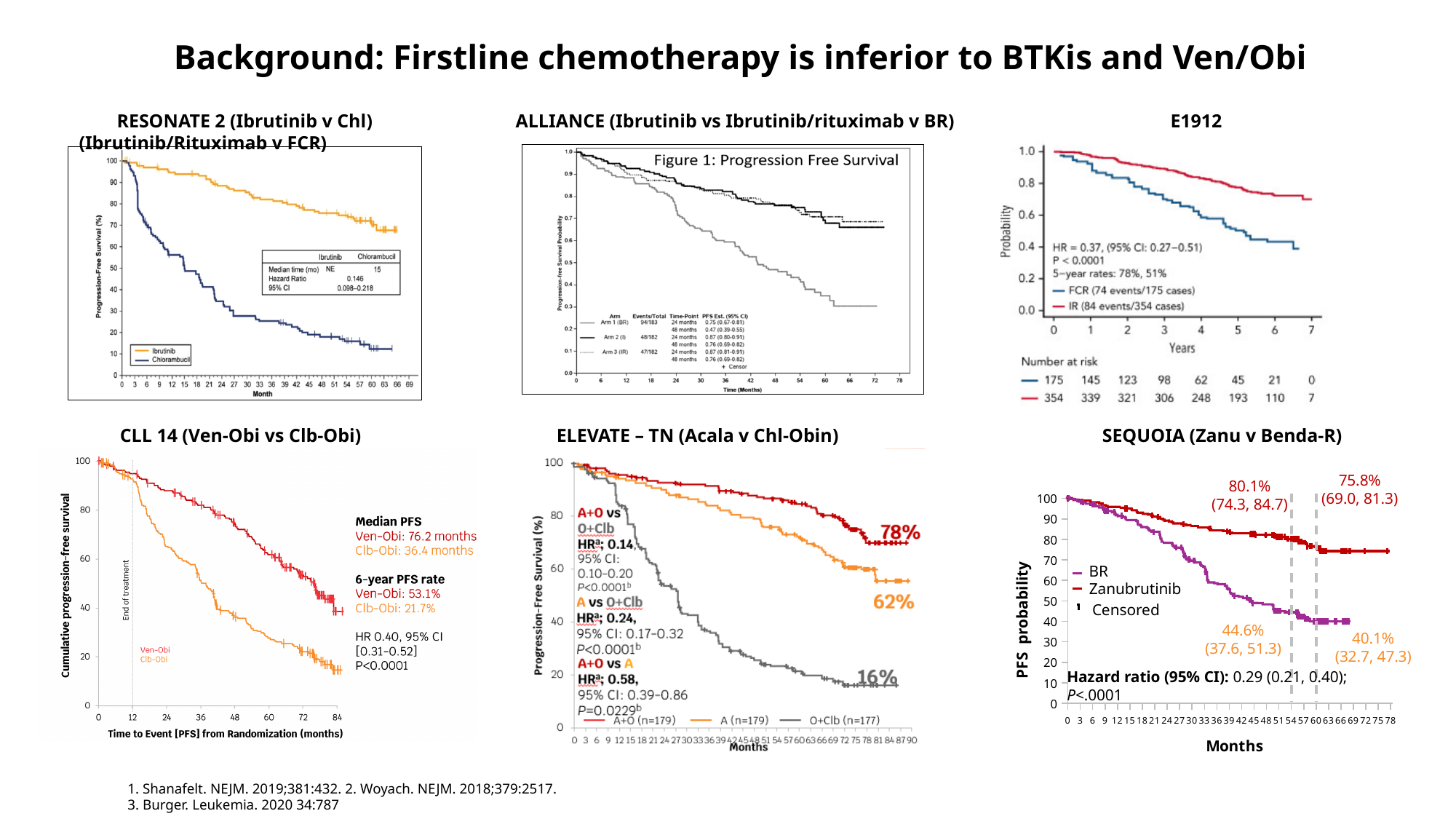
In the E1912 chart, what is the difference between the 5-year rates of the two arms (78% and 51%)? 27 percentage points In the ALLIANCE chart, what is the 48-month PFS estimate for Arm 1 (BR)? 0.47 (0.39-0.55) In the CLL 14 chart, what is the difference between the 6-year PFS rates of Ven-Obi (53.1%) and Clb-Obi (21.7%)? 31.4 percentage points What kind of chart is the CLL 14 (Ven-Obi vs Clb-Obi) chart? Line chart (Kaplan-Meier survival curve) In the RESONATE 2 chart, what is the median time (months) for Chlorambucil? 15 How many series does the legend of the ELEVATE – TN chart list? 3 In the CLL 14 chart, what is the median PFS for Ven-Obi? 76.2 months In the SEQUOIA chart, which arm has the higher PFS probability at the later dashed line: Zanubrutinib (75.8%) or BR (40.1%)? Zanubrutinib In the SEQUOIA chart, does the BR curve rise or fall as months increase? Fall In the RESONATE 2 chart, what is the hazard ratio shown in the inset table? 0.146 In the E1912 chart, what is the number at risk for the IR arm at 4 years? 248 In the ELEVATE – TN chart, which arm has the lowest labelled PFS rate at the end of the curve? O+Clb (16%)